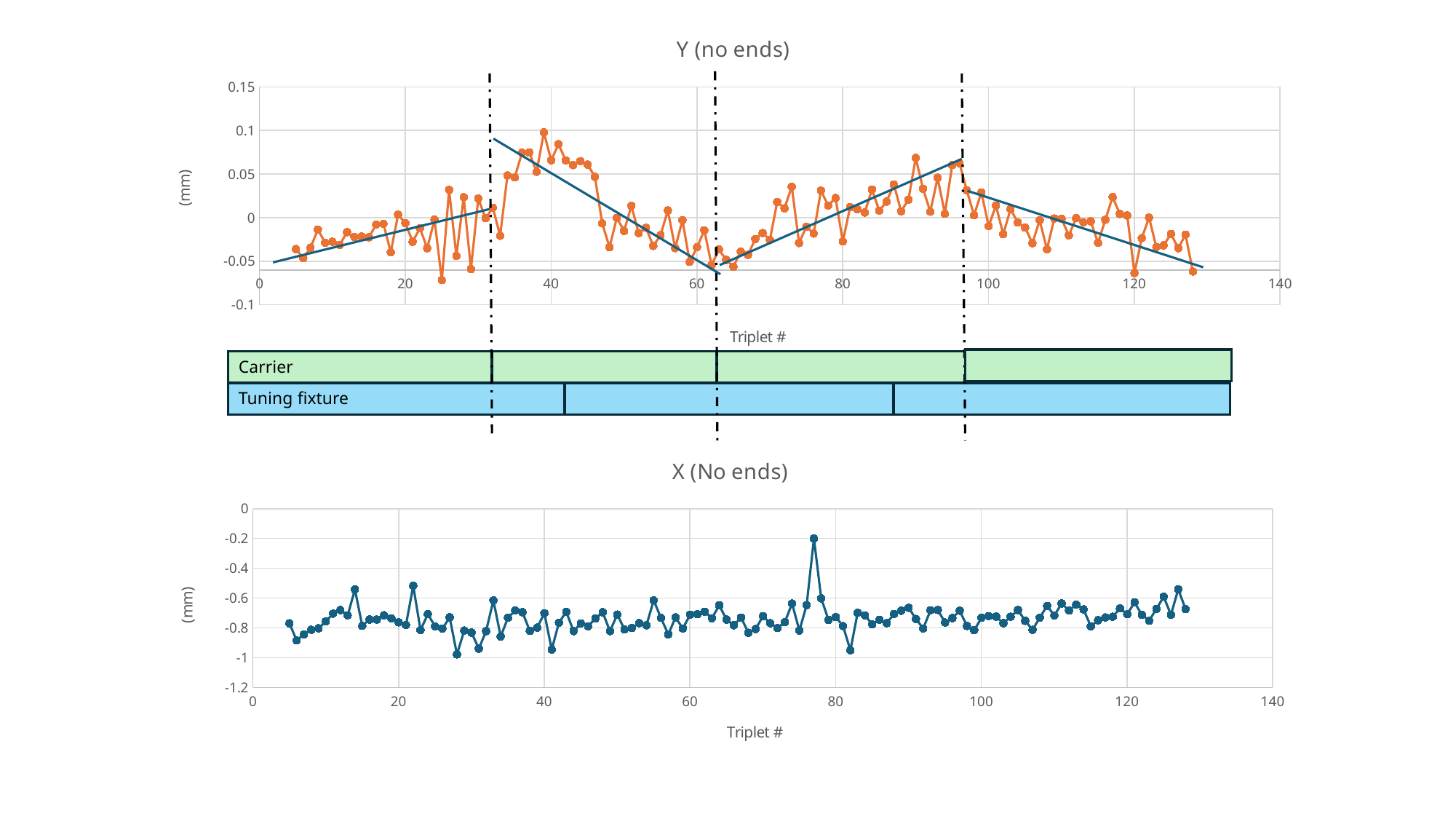
What kind of chart is the "Y (no ends)" chart? Line chart In the "X (No ends)" chart, is the value at the highest point greater or less than -0.6? greater In the "X (No ends)" chart, is the highest point greater or less than -0.4? greater What kind of chart is the "X (No ends)" chart? Line chart In the "Y (no ends)" chart, is the lowest point greater or less than -0.05? less How many charts are shown on the slide? 2 What is the x-axis label of the "X (No ends)" chart? Triplet # In the "Y (no ends)" chart, do the values rise or fall between triplet 65 and triplet 95? rise In the "Y (no ends)" chart, do the values rise or fall between triplet 40 and triplet 60? fall What unit is shown on the y-axis of the "Y (no ends)" chart? (mm)